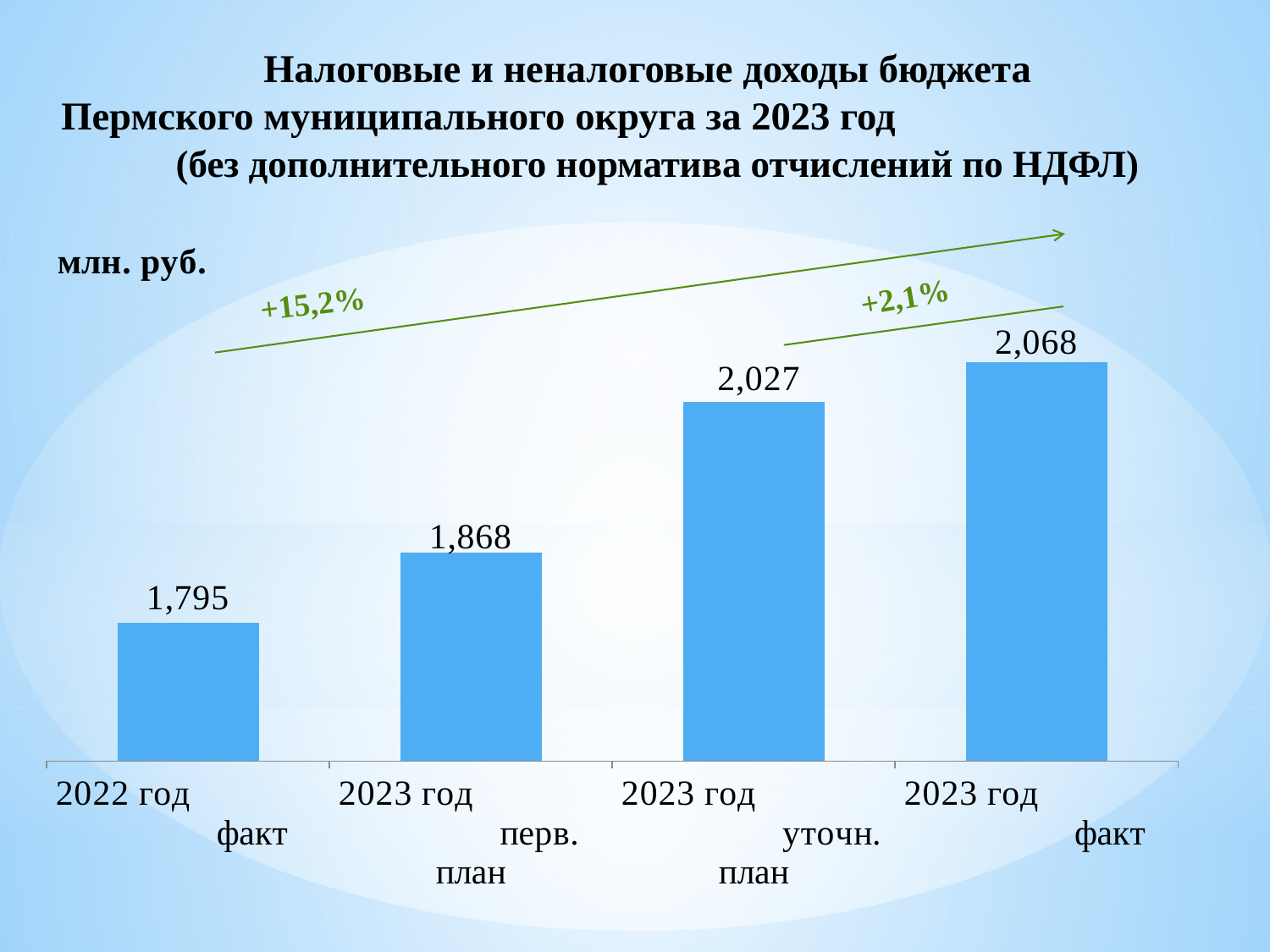
Which is larger, the value for 2023 год перв. план or the value for 2023 год уточн. план? 2023 год уточн. план What is the difference between the values for 2023 год факт and 2022 год факт? 273 What is the value for 2022 год факт? 1,795 What is the value for 2023 год факт? 2,068 What is the value for 2023 год перв. план? 1,868 Do the values rise or fall from left to right along the x axis? Rise Which category has the highest value? 2023 год факт What is the difference between the values for 2023 год уточн. план and 2023 год перв. план? 159 Which category has the lowest value? 2022 год факт What is the value for 2023 год уточн. план? 2,027 How many bars are shown in the chart? 4 What kind of chart is shown on the slide? Bar chart